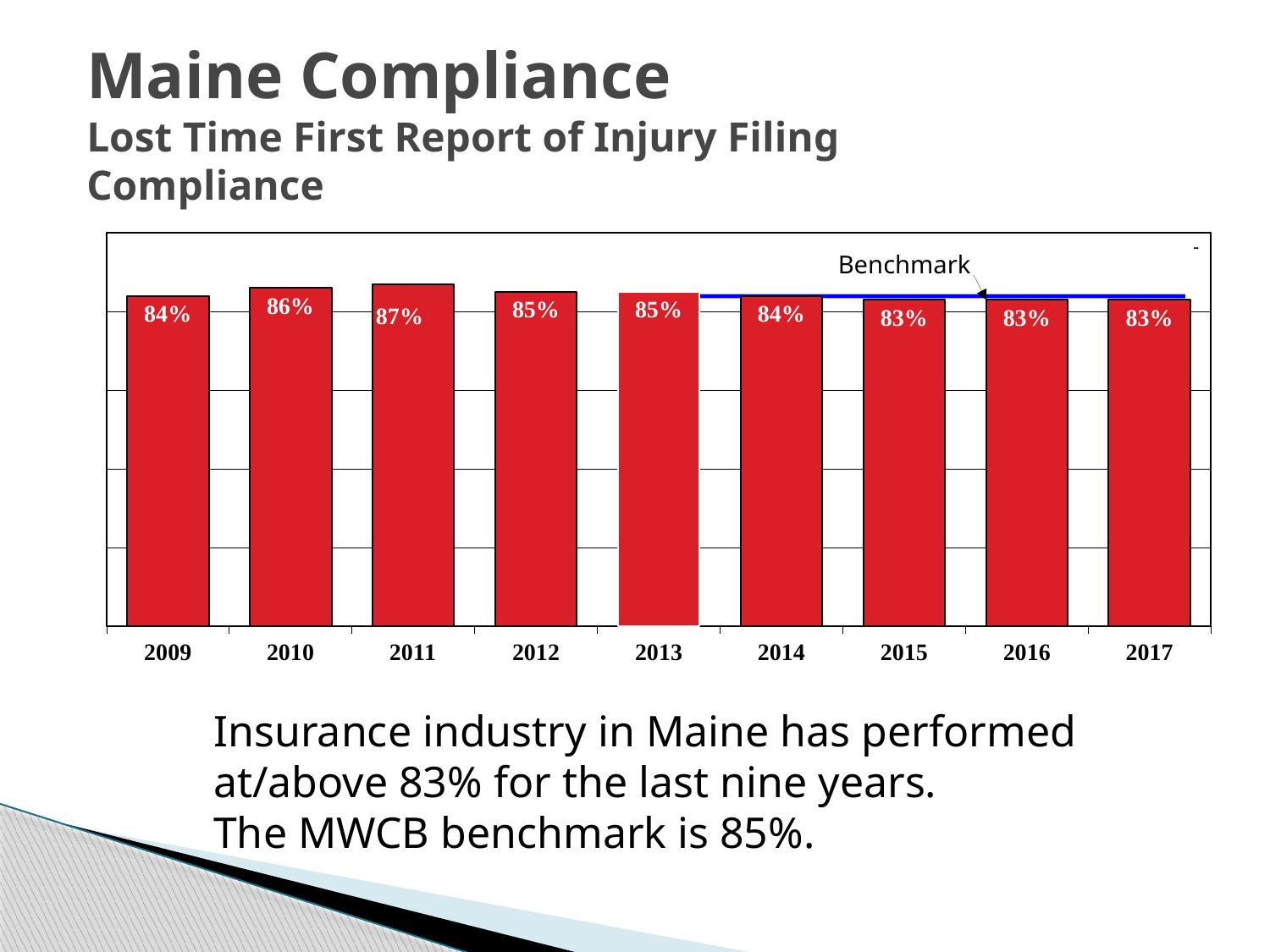
Which year has the highest compliance value? 2011 What is the difference between the compliance values for 2011 and 2017? 4% Do the compliance values rise or fall from 2013 to 2017? Fall How many years are shown on the x axis? 9 What is the compliance value for 2017? 83% What is the compliance value for 2013? 85% What is the difference between the compliance values for 2010 and 2014? 2% What kind of chart is shown on the slide? Bar chart What is the compliance value for 2009? 84% Which year has the larger compliance value, 2010 or 2015? 2010 What is the compliance value for 2011? 87% What does the blue horizontal line on the chart represent? Benchmark